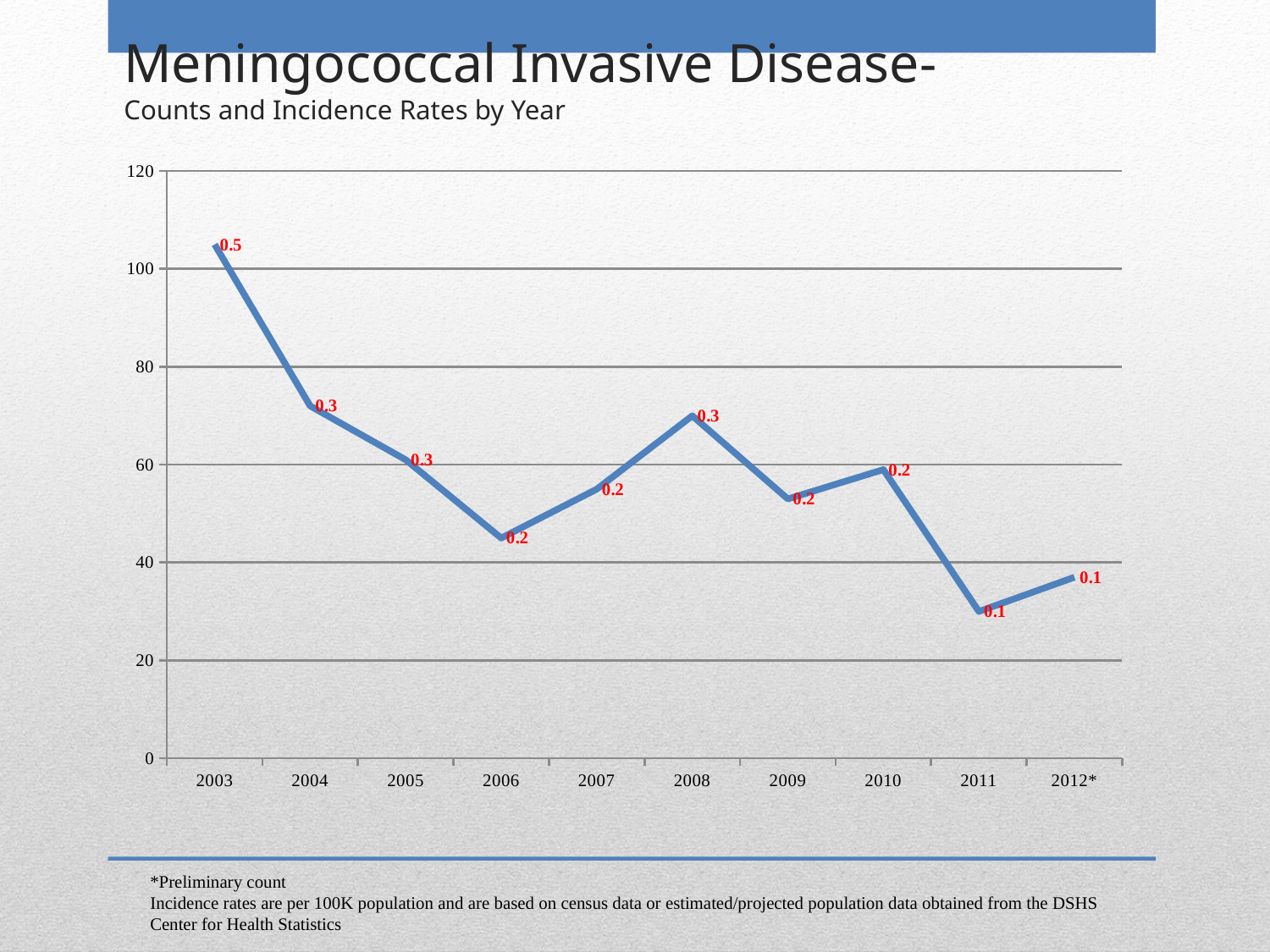
Is the count for 2008 greater or less than 60? greater Which year has the larger count, 2008 or 2009? 2008 What incidence rate is labelled on the 2003 data point? 0.5 What incidence rate is labelled on the 2011 data point? 0.1 Which year has the highest count on the line? 2003 Which year has the lowest count on the line? 2011 What kind of chart is shown on the slide? line chart Is the count for 2011 greater or less than 40? less How many years are plotted along the x axis? 10 Overall, do the counts rise or fall from 2003 to 2012*? fall What incidence rate is labelled on the 2008 data point? 0.3 Is the count for 2003 greater or less than 100? greater